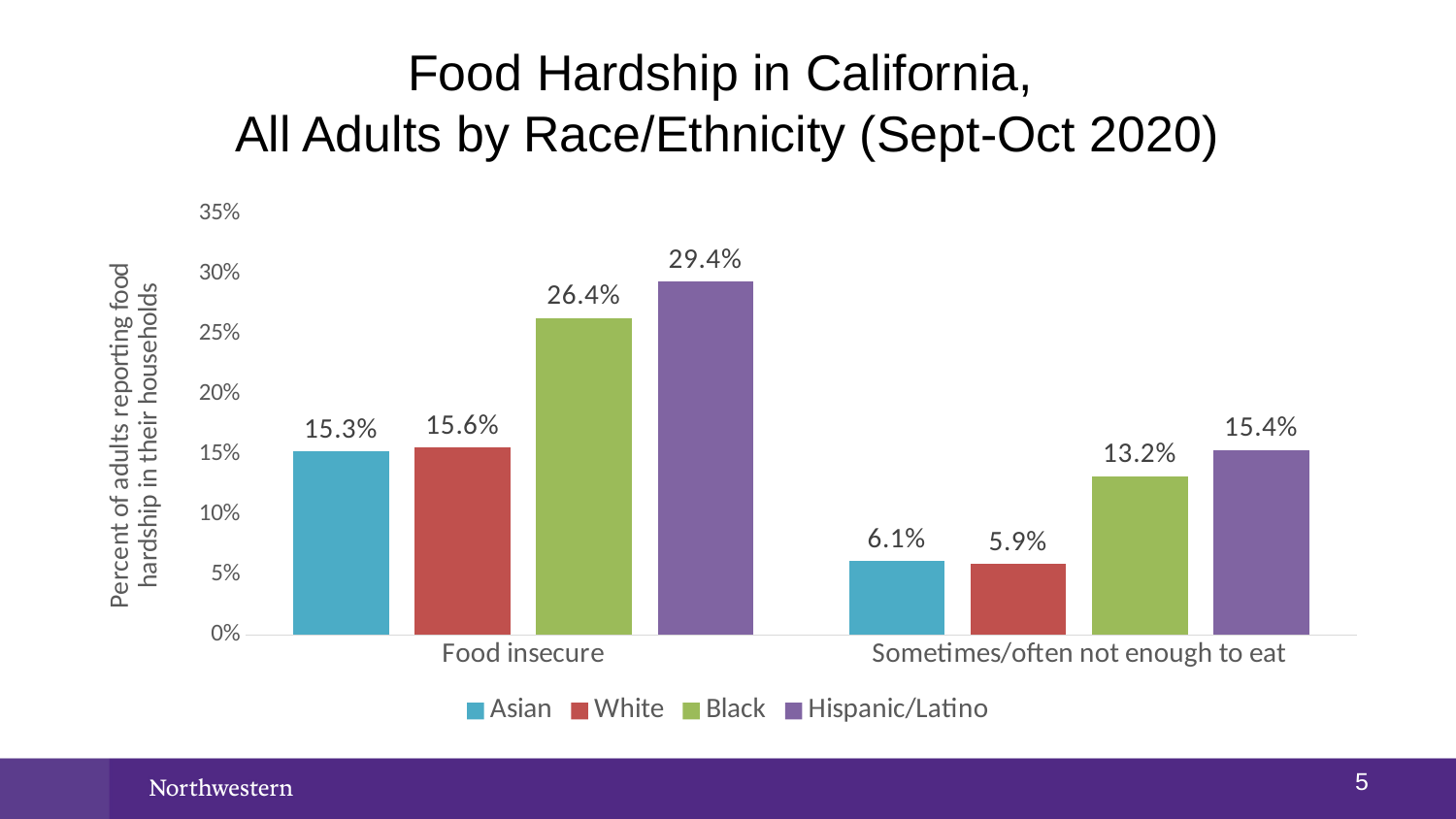
What is the value for Hispanic/Latino in the Food insecure category? 29.4% What is the difference between the Hispanic/Latino and Black values in the Food insecure category? 3.0% How many series does the legend list? 4 Which is larger in the Sometimes/often not enough to eat category: Black or Hispanic/Latino? Hispanic/Latino What is the value for White in the Sometimes/often not enough to eat category? 5.9% Is the value for Black in the Food insecure category greater or less than 25%? greater What is the value for Black in the Food insecure category? 26.4% Which group has the highest value in the Food insecure category? Hispanic/Latino What is the label of the vertical axis? Percent of adults reporting food hardship in their households What is the difference between the Black and Asian values in the Sometimes/often not enough to eat category? 7.1% Which group has the lowest value in the Sometimes/often not enough to eat category? White What kind of chart is shown on the slide? Bar chart